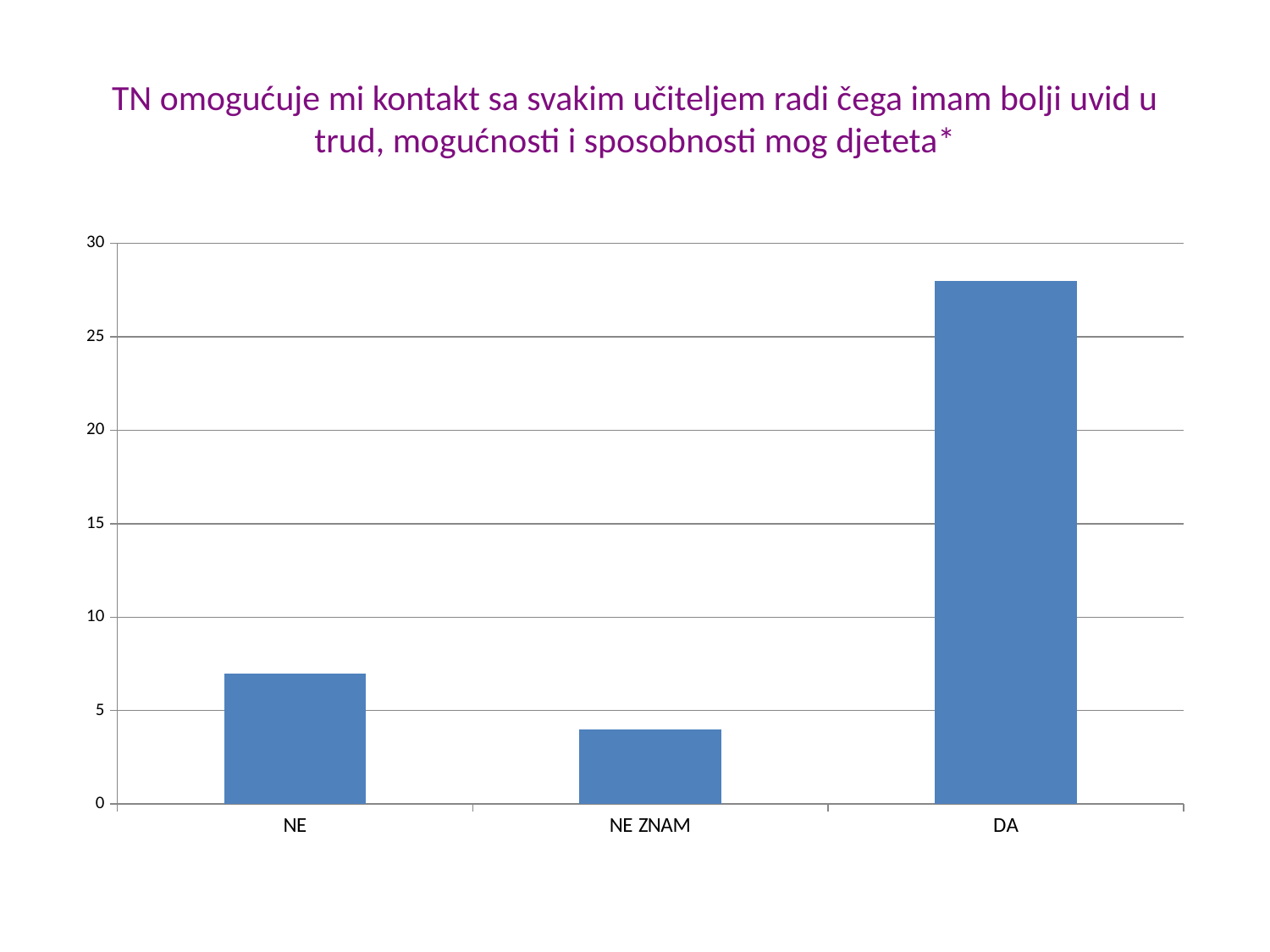
How many categories are shown on the x axis? 3 What is the label of the rightmost category on the x axis? DA Which category has the lowest value? NE ZNAM Is the value for DA greater or less than 25? greater What kind of chart is shown on the slide? bar chart Is the value for NE greater or less than 10? less Is the value for NE greater or less than 5? greater Which is larger, the value for NE or the value for NE ZNAM? NE Which category has the highest value? DA What is the highest value shown on the vertical axis? 30 Which is larger, the value for DA or the value for NE? DA